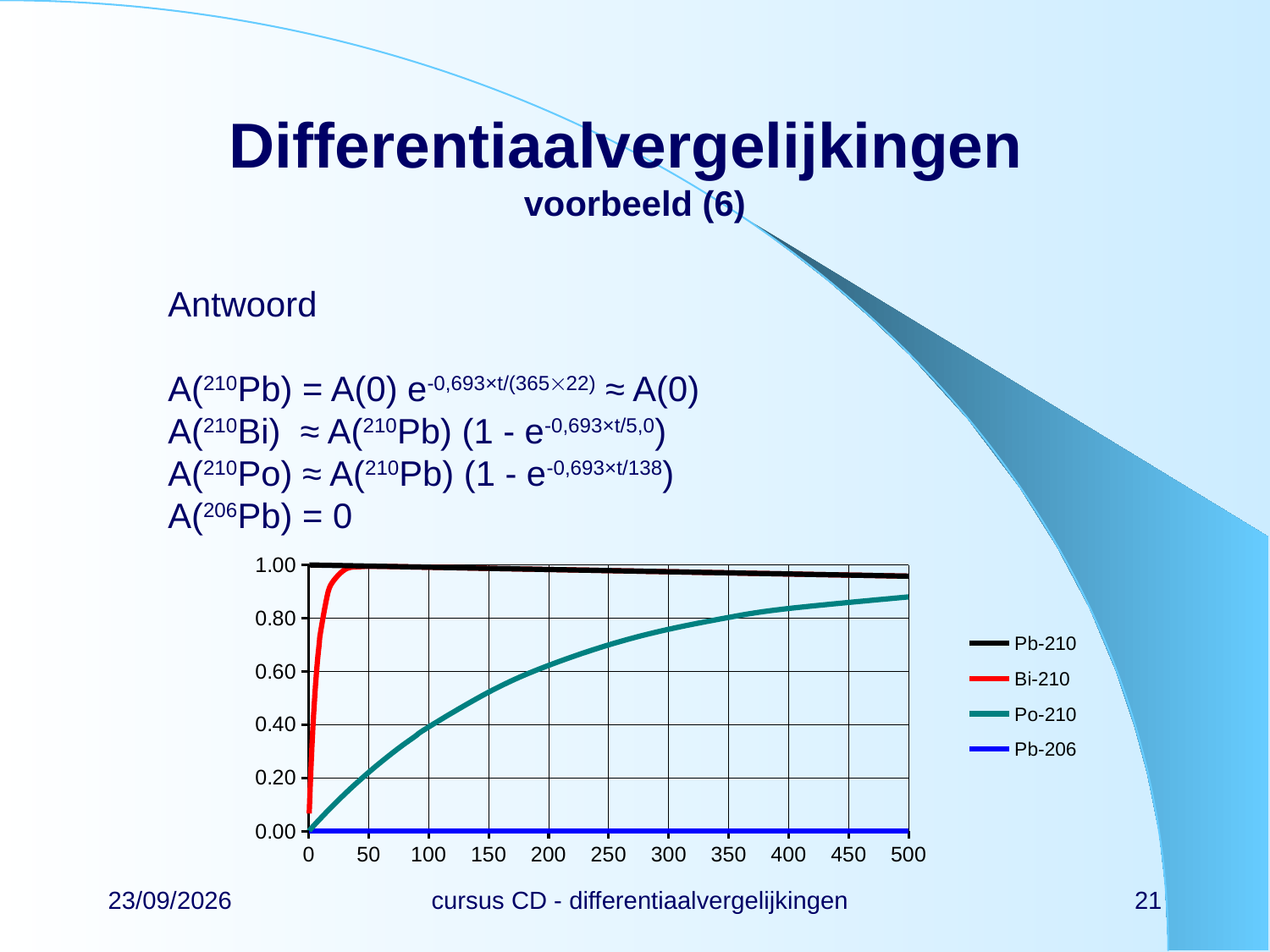
Is the value of Po-210 at x = 50 greater or less than 0.40? less Which series are listed in the chart legend? Pb-210, Bi-210, Po-210, Pb-206 What value does the Pb-206 line stay at across the whole chart? 0.00 Is the value of Bi-210 at x = 100 greater or less than 0.80? greater How many series does the chart legend list? 4 What colour is the Po-210 line in the chart? teal (green) At x = 200, which is larger: the Pb-210 value or the Po-210 value? Pb-210 What kind of chart is shown on the slide? line chart Which series has the lowest values across the chart? Pb-206 Does the Po-210 line rise or fall as x increases from 0 to 500? rise Is the value of Po-210 at x = 300 greater or less than 0.60? greater Does the Pb-210 line rise or fall as x increases from 0 to 500? fall